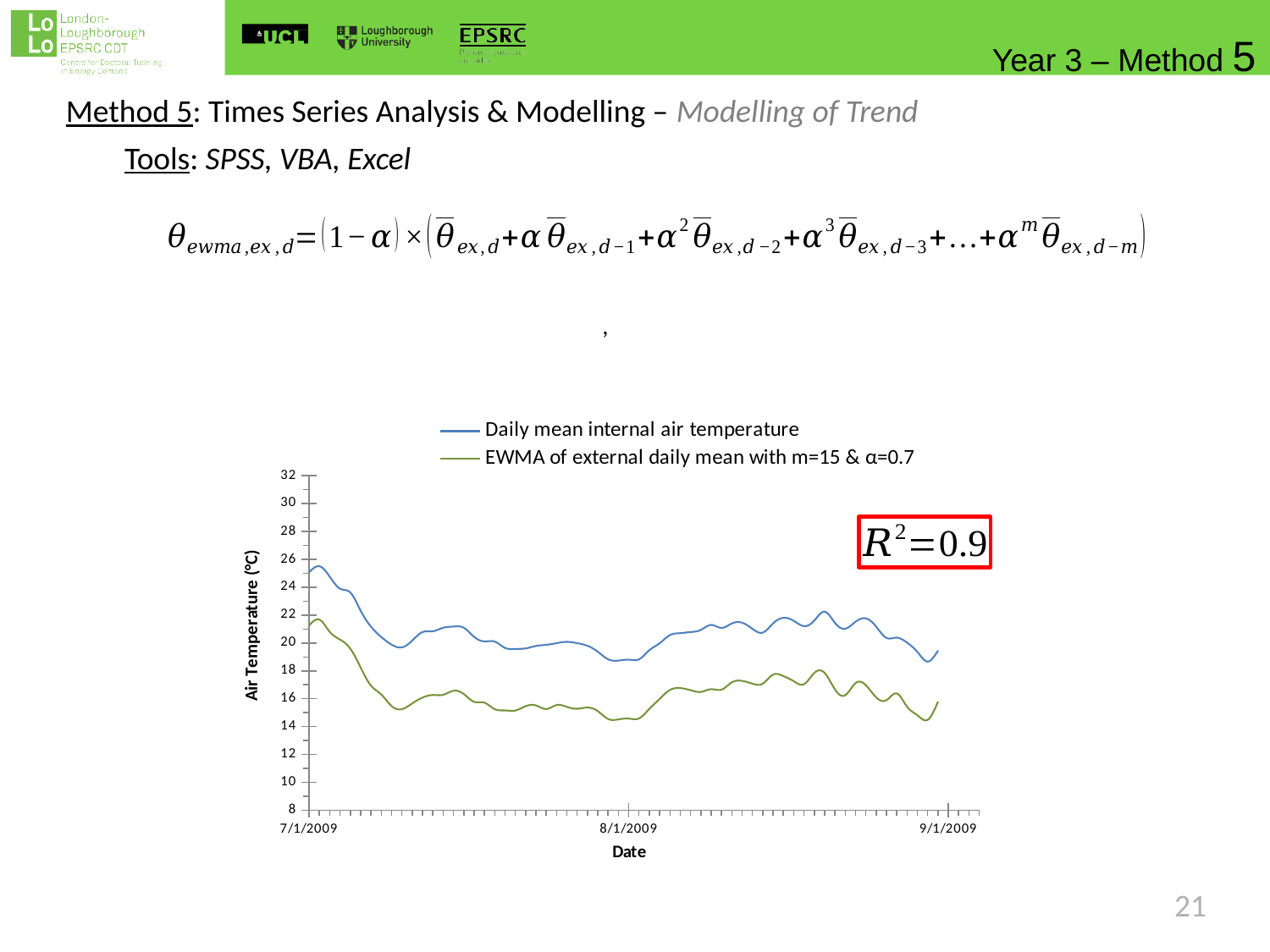
Is the value of the EWMA of external daily mean at the start of the chart (7/1/2009) greater or less than 20? greater What is the label of the x axis of the chart? Date Is the value of the EWMA of external daily mean around 8/1/2009 greater or less than 16? less What is the label of the y axis of the chart? Air Temperature (°C) What is the highest value shown on the y axis of the chart? 32 Which series is plotted higher on the chart throughout the period, the daily mean internal air temperature or the EWMA of external daily mean? Daily mean internal air temperature Does the daily mean internal air temperature rise or fall over the first part of July 2009? fall How many series does the chart's legend list? 2 Is the value of the EWMA of external daily mean at the end of the chart (near 9/1/2009) greater or less than 18? less What kind of chart is shown on the slide? line chart